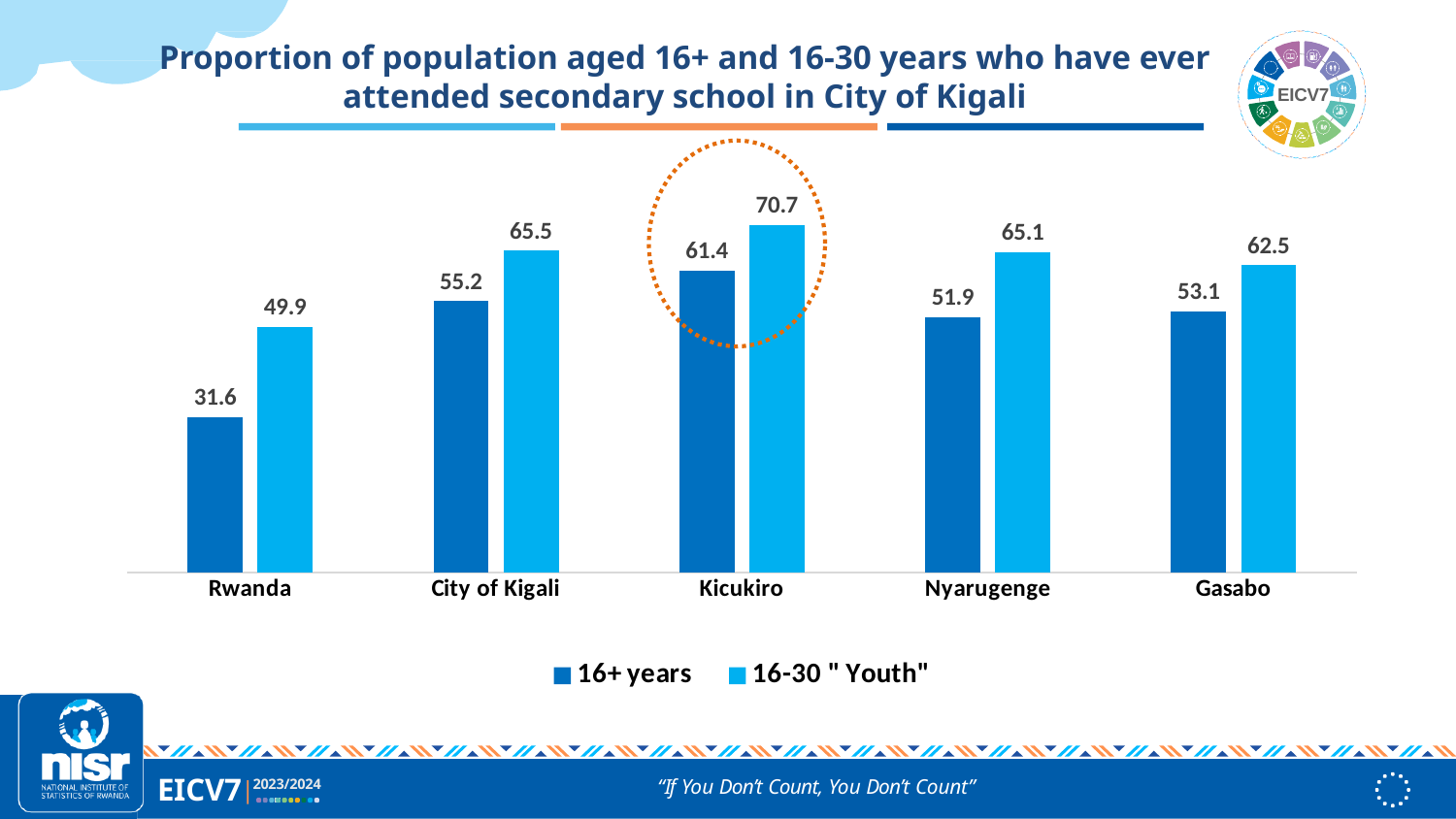
How many series does the legend list? 2 What is the difference between the 16-30 "Youth" and 16+ years values in Nyarugenge? 13.2 Which category is highlighted with a dashed orange circle? Kicukiro What is the value for 16+ years in Rwanda? 31.6 How many categories are shown on the x axis? 5 Which category has the highest value for 16-30 "Youth"? Kicukiro What kind of chart is shown on the slide? Bar chart What is the difference between the 16-30 "Youth" values for Kicukiro and Gasabo? 8.2 Which category has the lowest value for 16+ years? Rwanda Which is larger: the 16+ years value for City of Kigali or for Kicukiro? Kicukiro What is the value for 16+ years in Gasabo? 53.1 What is the value for 16-30 "Youth" in Kicukiro? 70.7